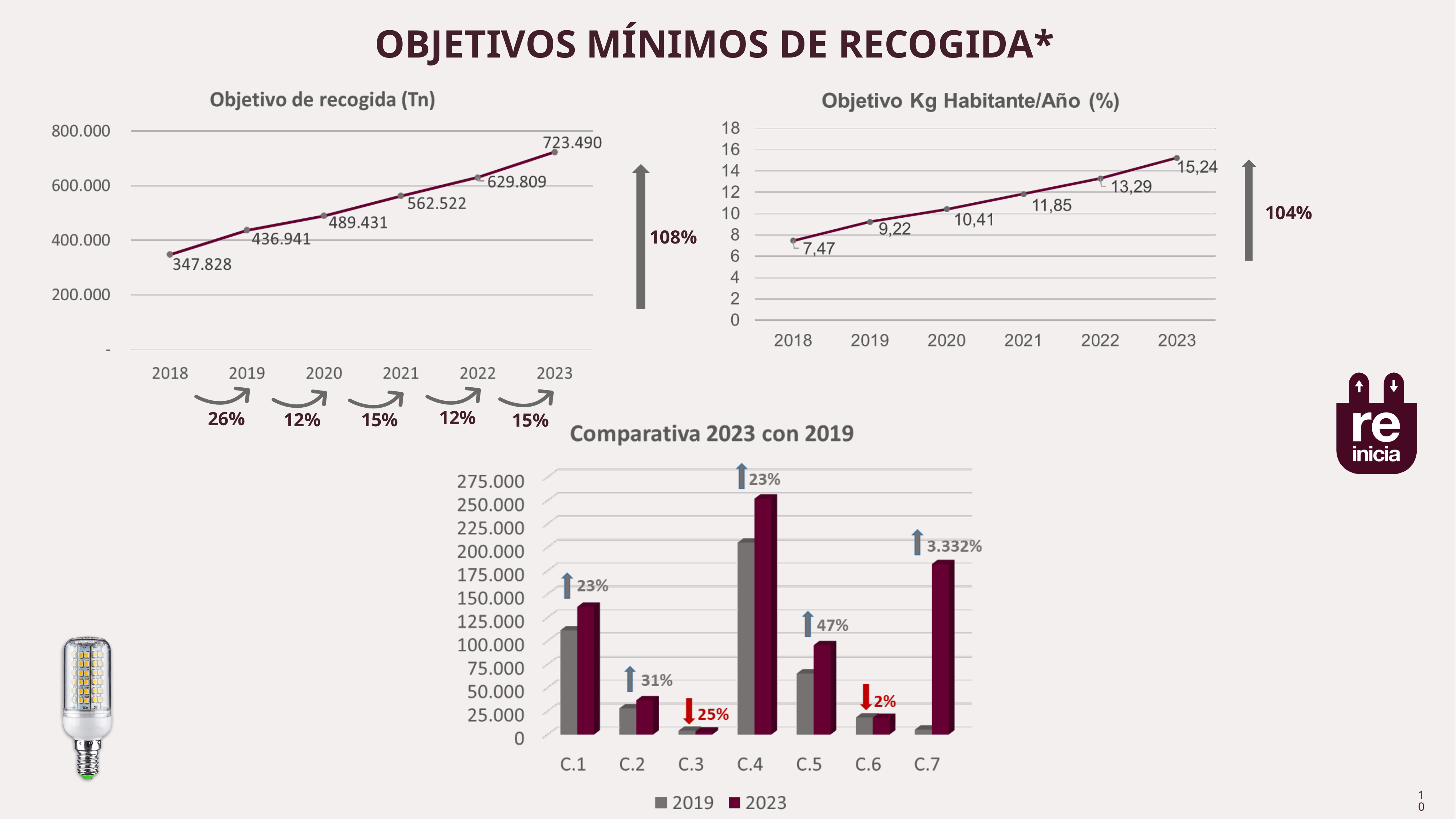
In the 'Objetivo de recogida (Tn)' chart, do the values rise or fall from 2018 to 2023? rise In the 'Objetivo de recogida (Tn)' chart, what is the difference between the 2022 and 2021 values? 67.287 In the 'Objetivo de recogida (Tn)' chart, what is the value for 2018? 347.828 In the 'Objetivo Kg Habitante/Año (%)' chart, what is the value for 2020? 10,41 What kind of chart is 'Comparativa 2023 con 2019'? bar chart In the 'Comparativa 2023 con 2019' chart, how many series does the legend list? 2 In the 'Objetivo de recogida (Tn)' chart, what is the value for 2023? 723.490 In the 'Comparativa 2023 con 2019' chart, is the 2019 value for C.1 greater or less than 100.000? greater In the 'Objetivo Kg Habitante/Año (%)' chart, how many data points are plotted? 6 In the 'Comparativa 2023 con 2019' chart, which category has the highest 2023 value? C.4 In the 'Objetivo Kg Habitante/Año (%)' chart, which year has the lowest value? 2018 In the 'Comparativa 2023 con 2019' chart, which is larger for C.5: the 2019 value or the 2023 value? 2023